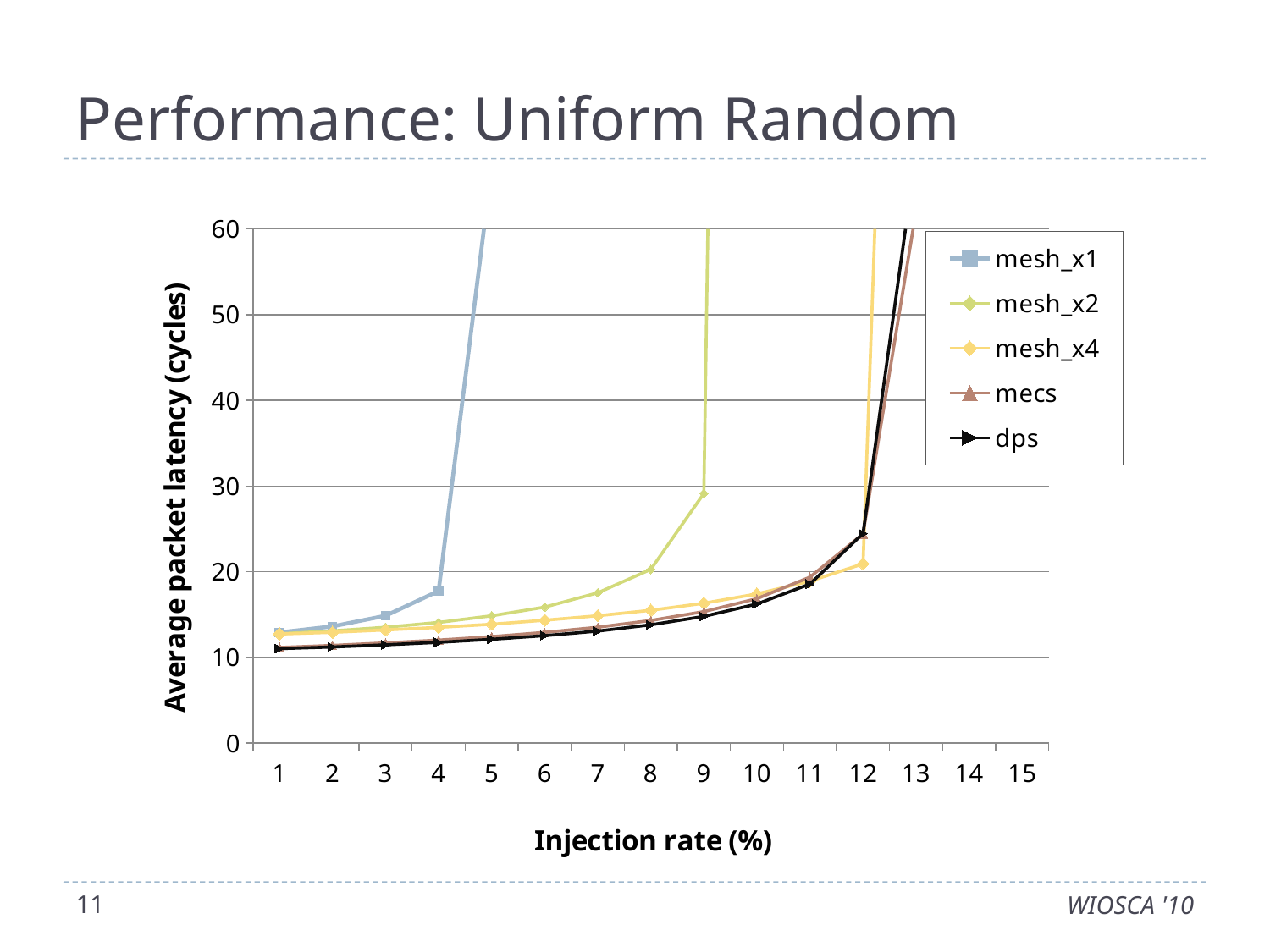
Which series rises above 60 cycles at the lowest injection rate? mesh_x1 At injection rate 4, which series has the higher latency, mesh_x1 or dps? mesh_x1 How many series does the legend list? 5 Is the value for dps at injection rate 1 greater or less than 10? greater What is the title of the x axis? Injection rate (%) Is the value for mesh_x2 at injection rate 7 greater or less than 20? less What is the title of the y axis? Average packet latency (cycles) At injection rate 9, which series has the higher latency, mesh_x2 or mesh_x4? mesh_x2 Does the latency for dps rise or fall as the injection rate increases? rise What kind of chart is shown on the slide? line chart Is the value for mesh_x1 at injection rate 4 greater or less than 20? less